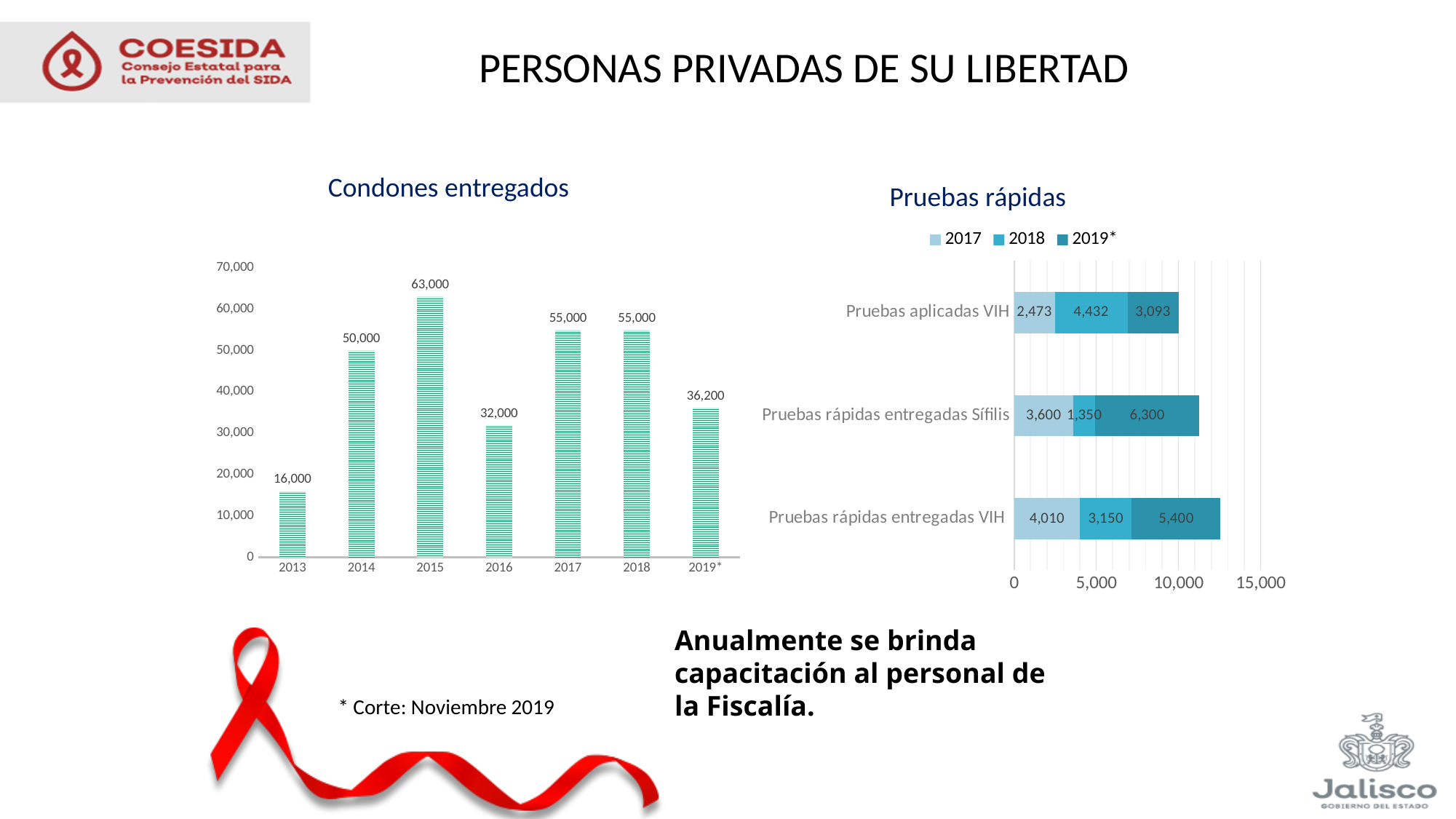
In the 'Pruebas rápidas' chart, how many series does the legend list? 3 In the 'Condones entregados' chart, what is the difference between the values for 2015 and 2016? 31,000 In the 'Pruebas rápidas' chart, what is the total of the stacked bar for 'Pruebas rápidas entregadas VIH'? 12,560 In the 'Condones entregados' chart, is the value for 2019* greater or less than 40,000? less In the 'Condones entregados' chart, what is the value for 2015? 63,000 In the 'Pruebas rápidas' chart, which is larger for 'Pruebas rápidas entregadas Sífilis': the 2017 value or the 2018 value? 2017 In the 'Pruebas rápidas' chart, what is the difference between the 2019* values for 'Pruebas rápidas entregadas Sífilis' and 'Pruebas aplicadas VIH'? 3,207 In the 'Condones entregados' chart, how many years are shown on the x axis? 7 What kind of chart is the 'Pruebas rápidas' chart? Stacked bar chart In the 'Condones entregados' chart, which year has the highest value? 2015 In the 'Pruebas rápidas' chart, what is the 2018 value for 'Pruebas aplicadas VIH'? 4,432 In the 'Condones entregados' chart, which year has the lowest value? 2013